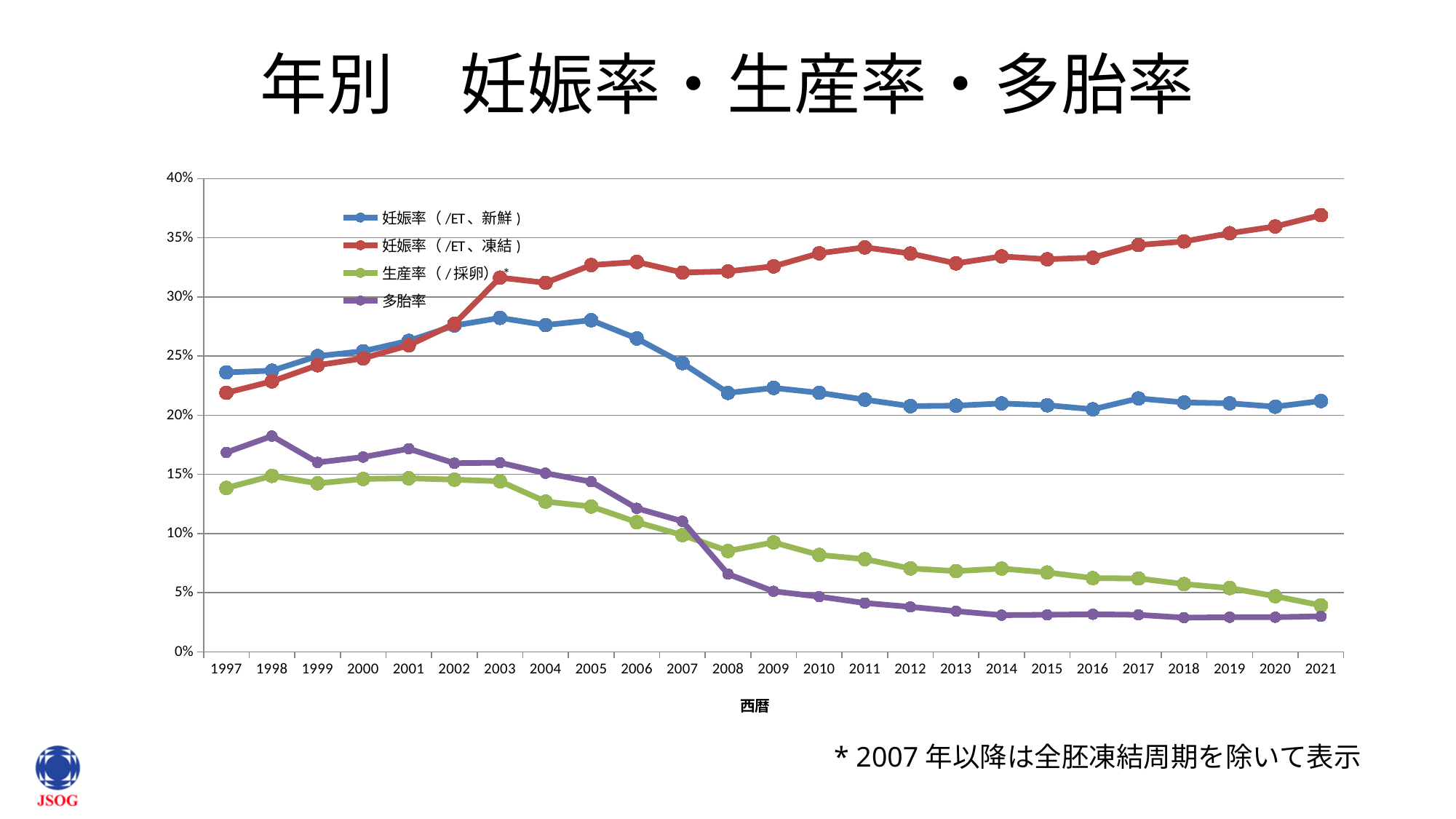
Does the 妊娠率（/ET、凍結）line rise or fall overall from 1997 to 2021? Rise Is the value for 生産率（/採卵）in 1997 greater or less than 15%? less How many years are plotted along the x axis? 25 Does the 多胎率 line rise or fall overall from 1997 to 2021? Fall In 2021, which is higher: 妊娠率（/ET、凍結）or 妊娠率（/ET、新鮮）? 妊娠率（/ET、凍結） What kind of chart is shown on the slide? Line chart Is the value for 多胎率 in 2021 greater or less than 5%? less Which series has the lowest value in 1997? 生産率（/採卵） Is the value for 妊娠率（/ET、新鮮）in 2003 greater or less than 25%? greater How many series does the legend list? 4 What is the title of the x axis? 西暦